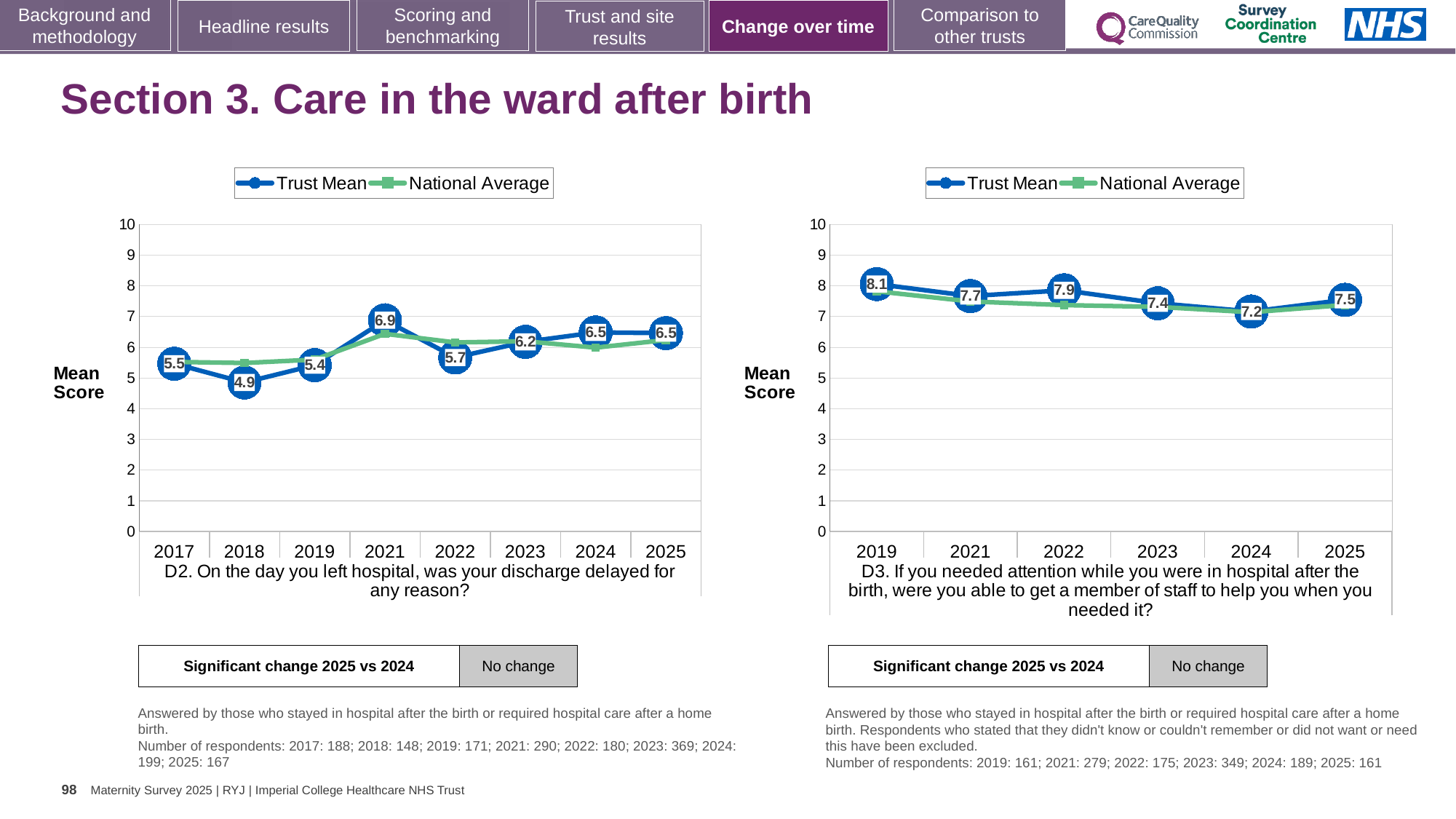
In the D3 chart (right), which year has the lowest Trust Mean? 2024 In the D3 chart (right), is the Trust Mean for 2022 greater or less than the Trust Mean for 2023? greater In the D2 chart (left), how many years are shown on the x axis? 8 What kind of chart is the D2 chart on the left? Line chart In the D2 chart (left), what is the Trust Mean for 2021? 6.9 In the D3 chart (right), what is the Trust Mean for 2019? 8.1 In the D2 chart (left), what is the Trust Mean for 2018? 4.9 In the D2 chart (left), which year has the lowest Trust Mean? 2018 In the D2 chart (left), what is the difference between the Trust Mean for 2021 and the Trust Mean for 2022? 1.2 In the D3 chart (right), what is the difference between the Trust Mean for 2019 and the Trust Mean for 2025? 0.6 In the D2 chart (left), which year has the highest Trust Mean? 2021 In the D3 chart (right), how many series does the legend list? 2